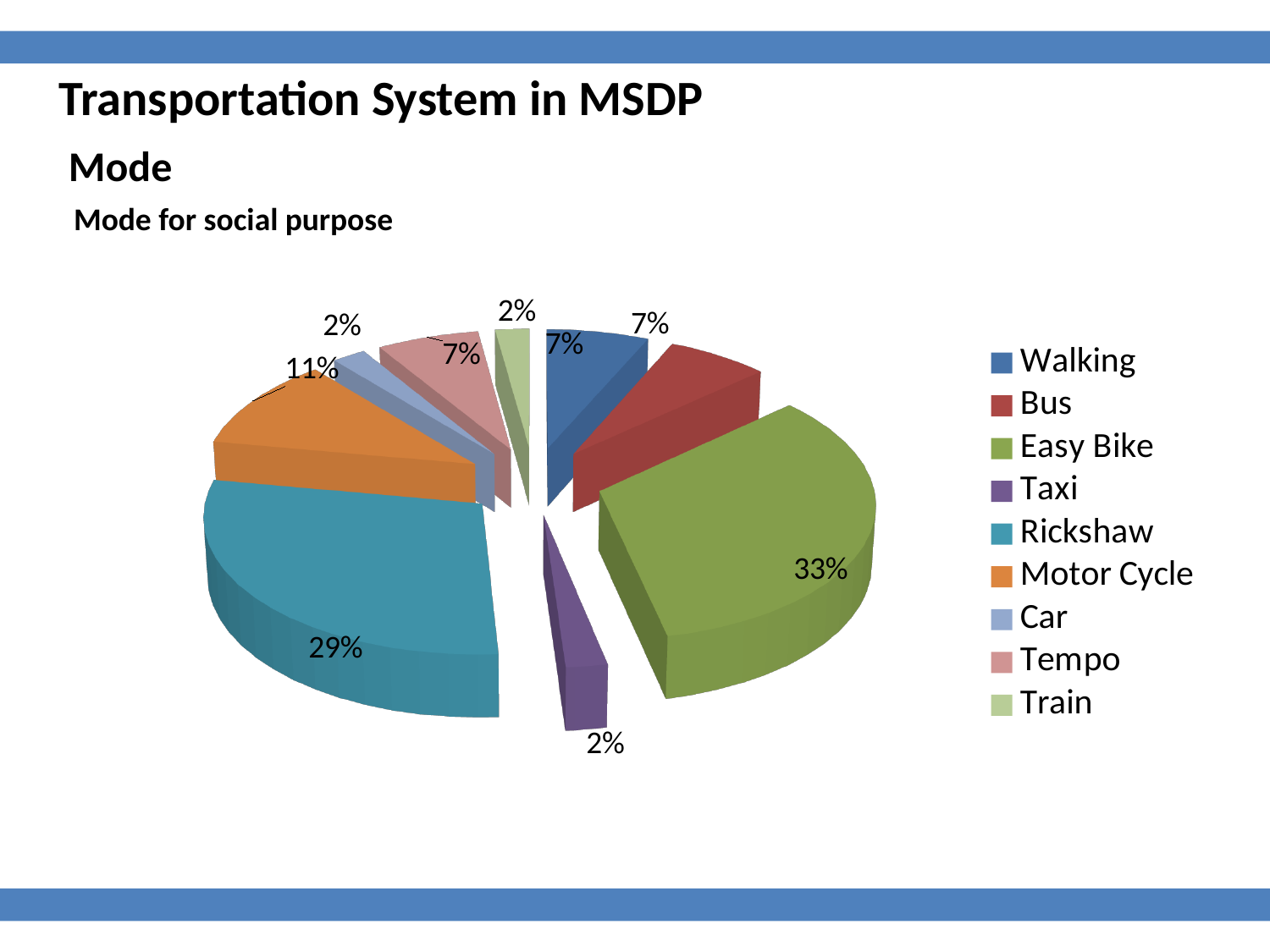
Which mode has the largest share of the pie? Easy Bike What kind of chart is shown on the slide? pie chart How many modes does the legend list? 9 Which is larger, the share for Rickshaw or the share for Motor Cycle? Rickshaw What share of the pie does Easy Bike have? 33% What is the title of the chart? Mode for social purpose What share of the pie does Rickshaw have? 29% Which legend entry is shown in orange? Motor Cycle What is the value for Taxi? 2% What is the difference between the shares for Motor Cycle and Bus? 4% What is the value for Motor Cycle? 11% What is the difference between the shares for Easy Bike and Rickshaw? 4%